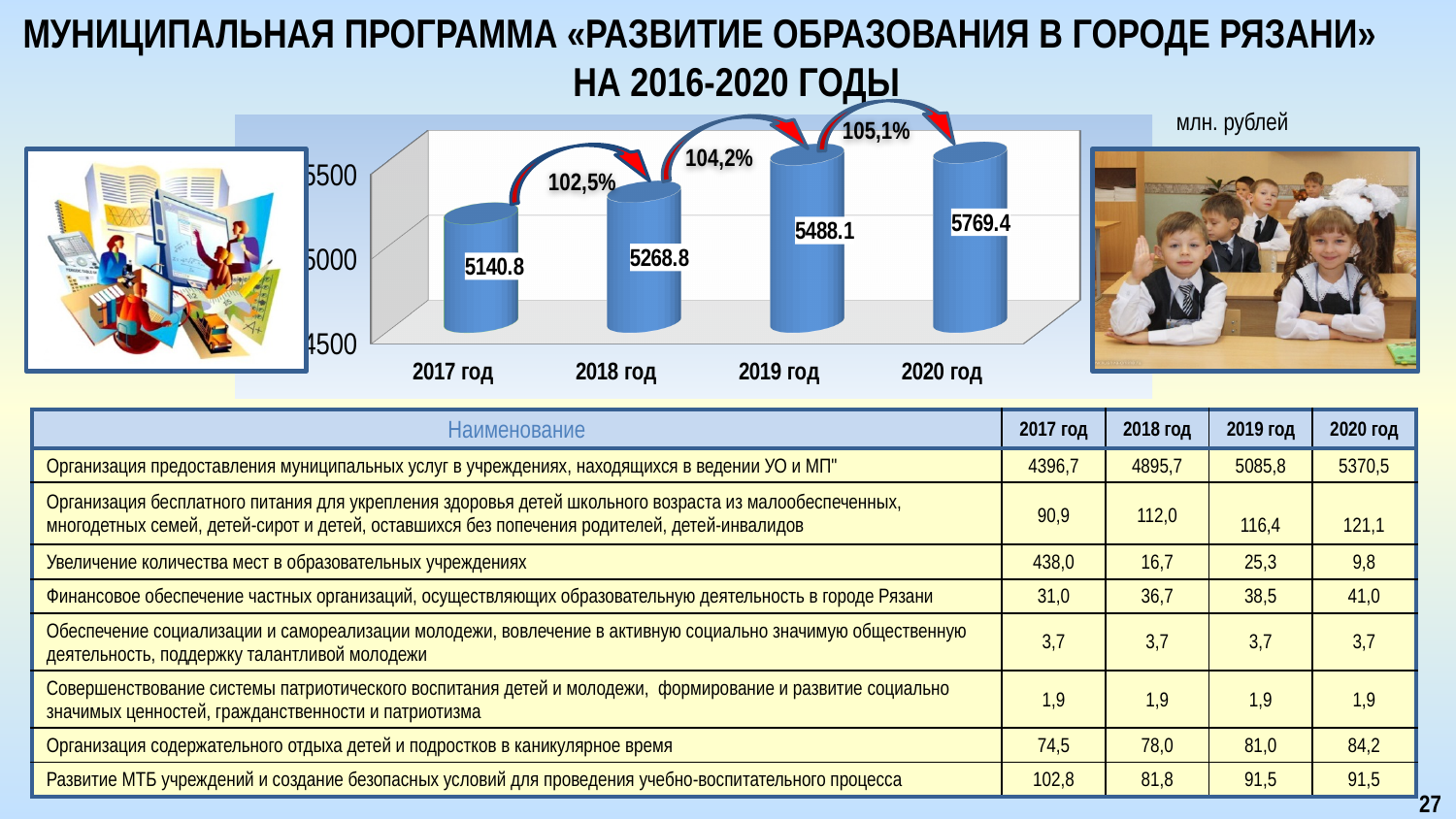
Which year has the highest value in the bar chart? 2020 год What is the difference between the values for 2020 год and 2019 год in the bar chart? 281.3 Which is larger in the bar chart, the value for 2018 год or the value for 2019 год? 2019 год Which year has the lowest value in the bar chart? 2017 год What is the value for 2019 год in the bar chart? 5488.1 How many years are shown in the bar chart? 4 What kind of chart is shown on the slide? bar chart What is the value for 2020 год in the bar chart? 5769.4 Is the value for 2020 год in the bar chart greater or less than 5500? greater What is the value for 2017 год in the bar chart? 5140.8 Do the values in the bar chart rise or fall from 2017 год to 2020 год? rise What is the difference between the values for 2018 год and 2017 год in the bar chart? 128.0